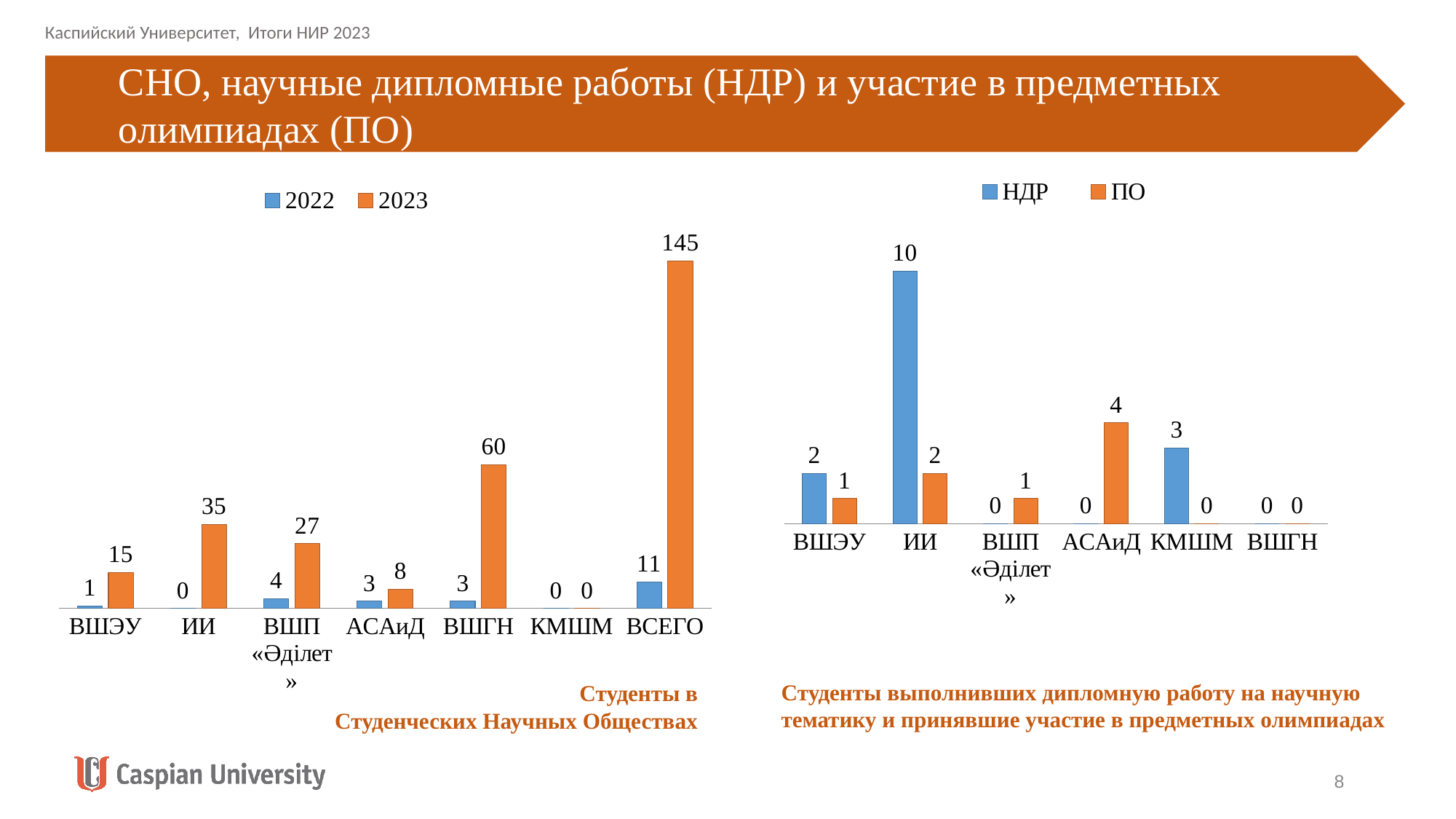
In the left chart (Студенты в Студенческих Научных Обществах), which category has the highest 2023 value? ВСЕГО In the right chart (НДР / ПО), what is the ПО value for АСАиД? 4 In the left chart (Студенты в Студенческих Научных Обществах), how many categories are shown on the x axis? 7 In the left chart (Студенты в Студенческих Научных Обществах), what is the 2022 value for ВСЕГО? 11 In the left chart (Студенты в Студенческих Научных Обществах), what is the difference between the 2023 and 2022 values for ИИ? 35 In the left chart (Студенты в Студенческих Научных Обществах), how many series does the legend list? 2 What type of chart is the right chart (НДР / ПО)? Bar chart In the right chart (НДР / ПО), what is the difference between the НДР and ПО values for ВШЭУ? 1 In the left chart (Студенты в Студенческих Научных Обществах), what is the 2023 value for ВШГН? 60 In the right chart (НДР / ПО), which category has the highest ПО value? АСАиД In the right chart (НДР / ПО), what is the НДР value for ИИ? 10 In the left chart (Студенты в Студенческих Научных Обществах), which is larger: the 2023 value for ВШП «Әділет» or the 2023 value for ВШЭУ? ВШП «Әділет»